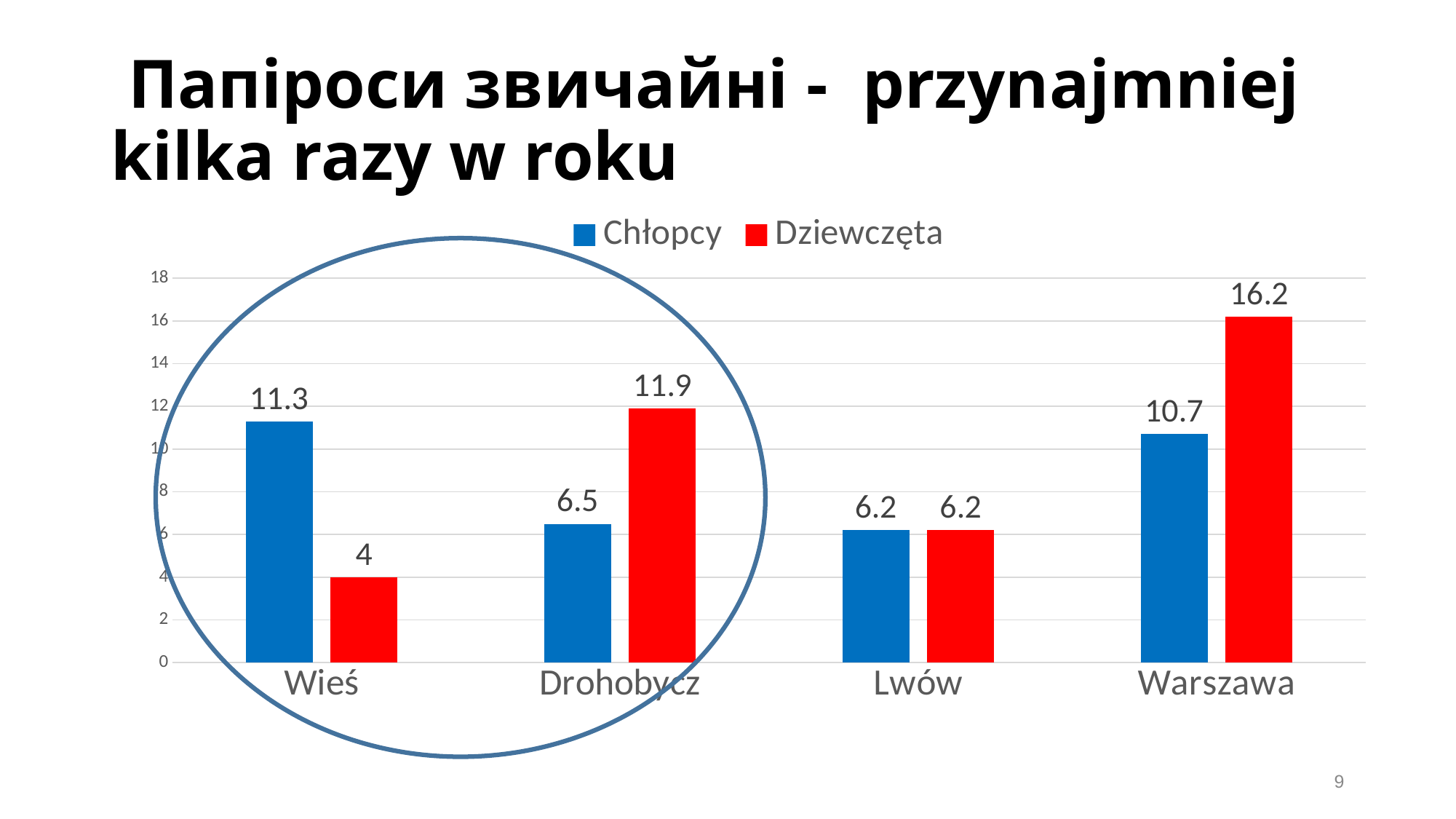
Which category has the lowest value for Chłopcy? Lwów What is the value for Chłopcy in Drohobycz? 6.5 Which category has the highest value for Dziewczęta? Warszawa What is the difference between the Dziewczęta and Chłopcy values in Warszawa? 5.5 What kind of chart is shown on the slide? bar chart What is the value for Chłopcy in Wieś? 11.3 What is the value for Dziewczęta in Wieś? 4 What is the value for Dziewczęta in Warszawa? 16.2 How many series does the legend list? 2 How many categories are shown on the x axis? 4 Which is larger in Drohobycz, the Chłopcy value or the Dziewczęta value? Dziewczęta Which colour represents Dziewczęta in the chart? red